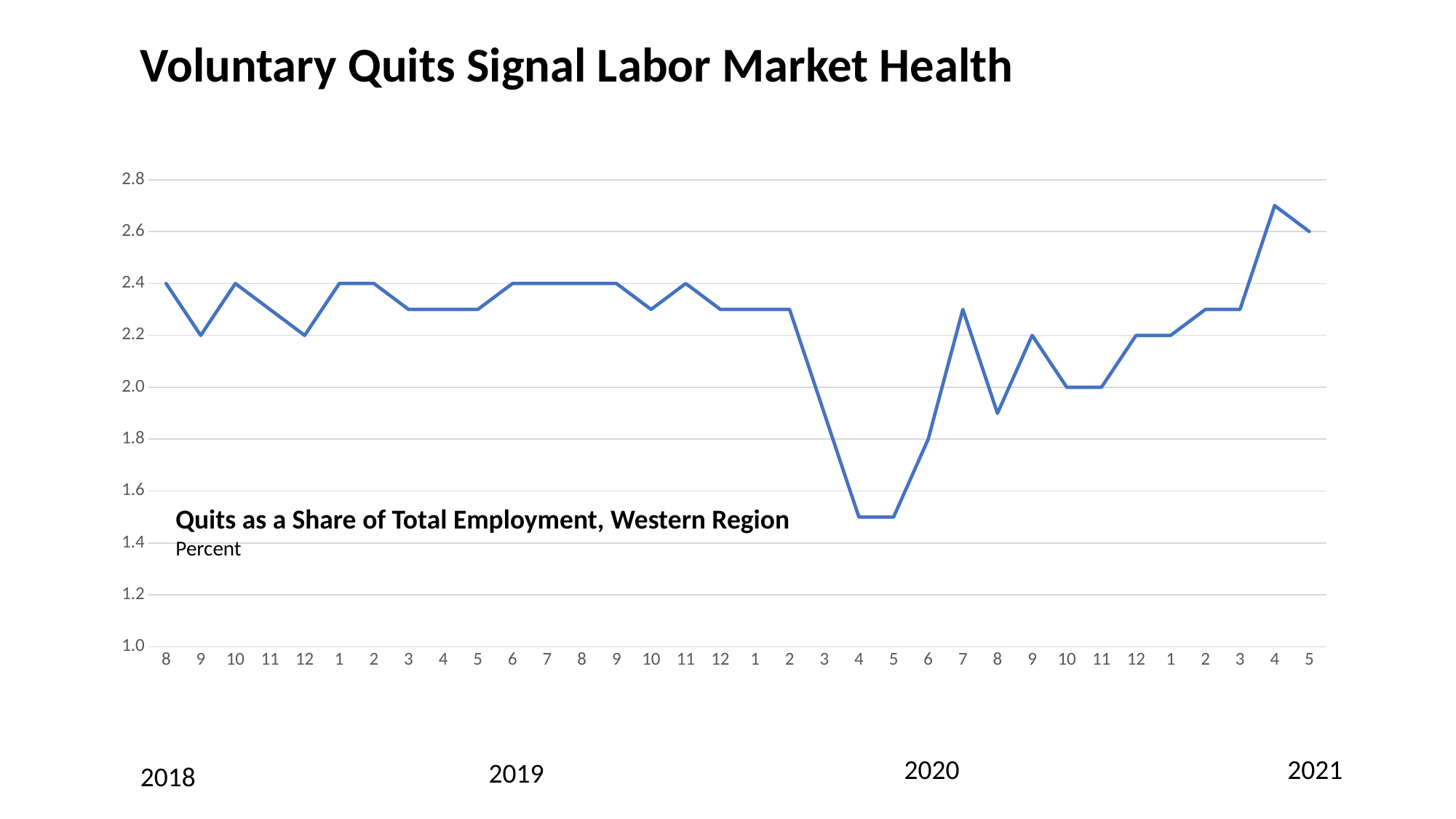
Which is larger, the value for month 8 of 2018 or the value for month 5 of 2021? month 5 of 2021 In which year and month does the line reach its highest point? month 4 of 2021 What unit is the chart measured in, according to the label under the chart subtitle? Percent In which year does the line reach its lowest point? 2020 What is the difference between the value for month 5 of 2021 and the value for month 8 of 2018? 0.2 Is the value for month 4 of 2021 greater or less than 2.6? greater Does the line rise or fall between month 5 of 2020 and month 4 of 2021? rise Is the value for month 4 of 2020 greater or less than 1.6? less What is the value for month 10 of 2020? 2.0 What is the value for month 8 of 2018, the first point on the line? 2.4 What is the value for month 5 of 2021, the last point on the line? 2.6 What kind of chart is shown on the slide? line chart